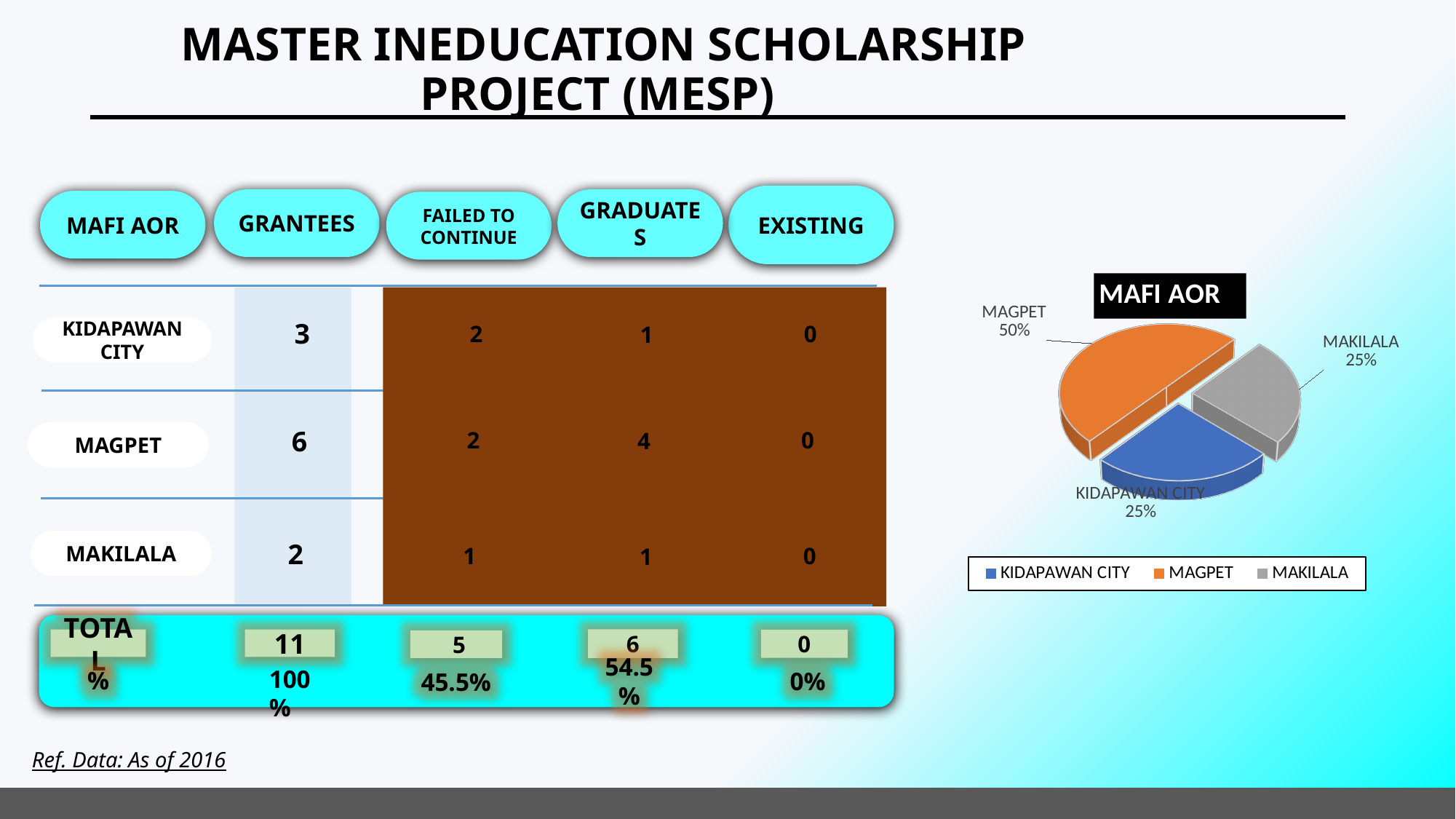
What is the title of the pie chart? MAFI AOR How many slices does the pie chart have? 3 Which is larger in the pie chart, MAGPET or MAKILALA? MAGPET What share of the pie chart does MAGPET have? 50% What share of the pie chart does KIDAPAWAN CITY have? 25% Which slice of the pie chart is the largest? MAGPET What is the difference between the MAGPET share and the KIDAPAWAN CITY share in the pie chart? 25% Which colour represents MAGPET in the pie chart? orange What kind of chart is shown on the slide? pie chart How many entries does the pie chart's legend list? 3 What share of the pie chart does MAKILALA have? 25%